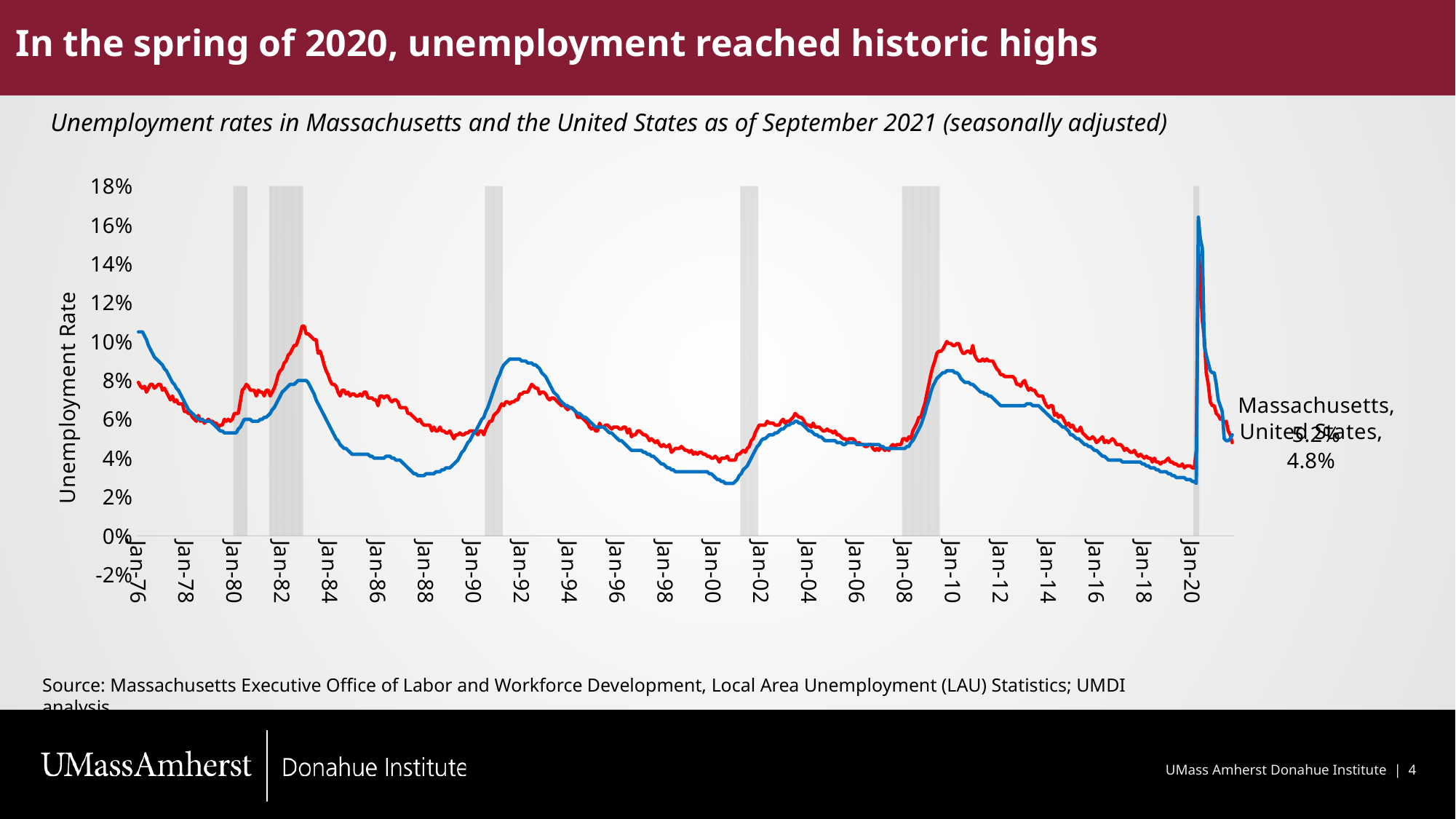
What is the difference between the latest Massachusetts rate and the latest United States rate? 0.4% Around Jan-92, which line is higher, Massachusetts or the United States? Massachusetts What is the latest unemployment rate shown for the United States? 4.8% Between Jan-10 and Jan-20, does the Massachusetts unemployment rate generally rise or fall? Fall How many series are plotted on the chart? 2 Is the peak Massachusetts unemployment rate in 2020 greater or less than 14%? greater What kind of chart is shown on the slide? Line chart Around Jan-84, which line is higher, Massachusetts or the United States? United States At the end of the series, which has the higher unemployment rate, Massachusetts or the United States? Massachusetts What is the highest value shown on the vertical axis? 18% What is the latest unemployment rate shown for Massachusetts? 5.2% What is the label on the vertical axis of the chart? Unemployment Rate